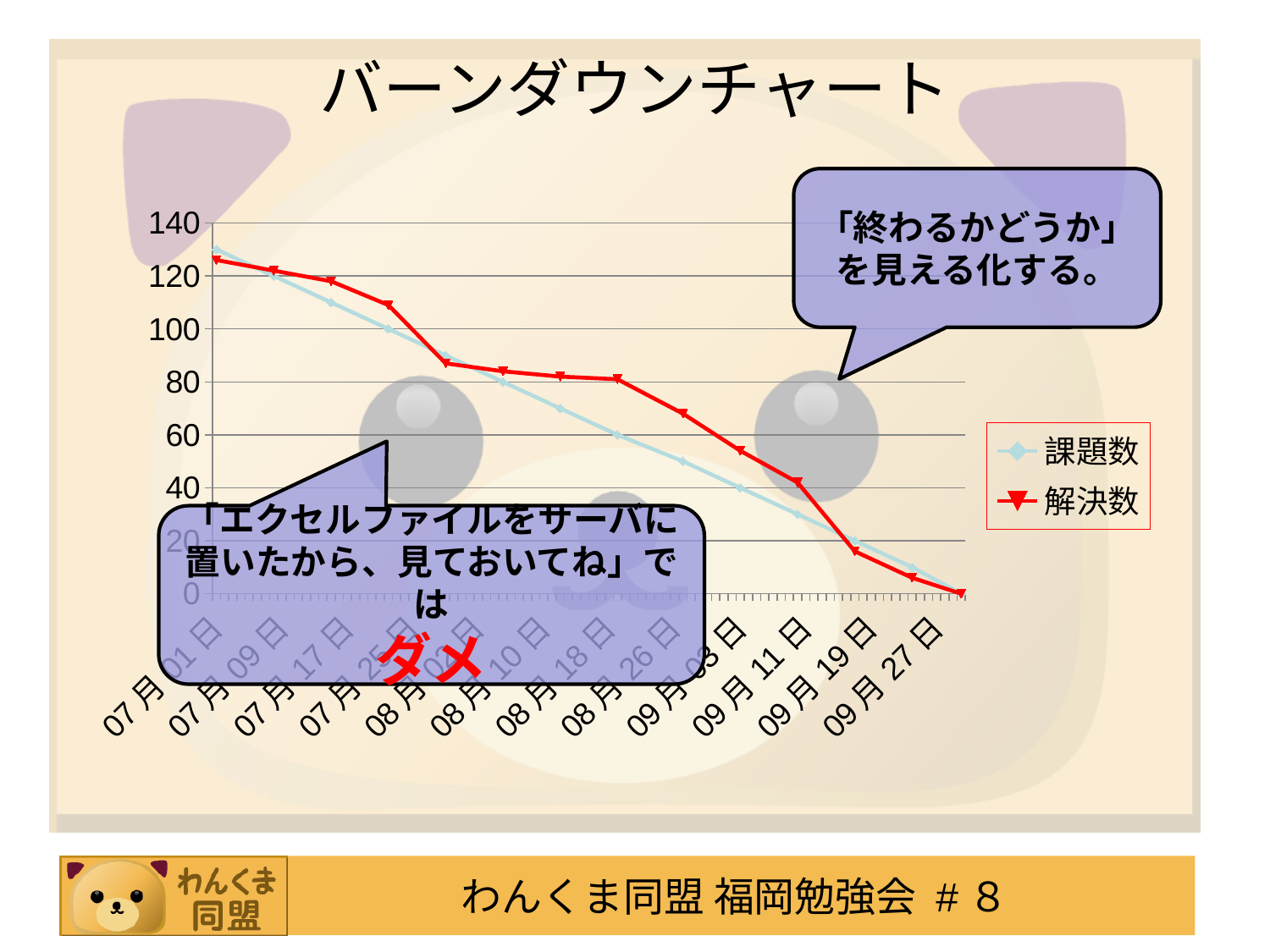
What is the highest value shown on the vertical axis? 140 What kind of chart is shown on the slide? line chart Is the value of 解決数 at 07月01日 greater or less than 120? greater What is the title of the slide containing the chart? バーンダウンチャート Do the values of 課題数 rise or fall from left to right along the x axis? fall Is the value of 課題数 at 07月01日 greater or less than 120? greater How many date labels are shown along the x axis? 12 At 08月26日, which series has the higher value, 課題数 or 解決数? 解決数 How many series does the legend list? 2 Is the value of 解決数 at 09月19日 greater or less than 40? less What are the two series named in the legend? 課題数 and 解決数 Do the values of 解決数 rise or fall from left to right along the x axis? fall